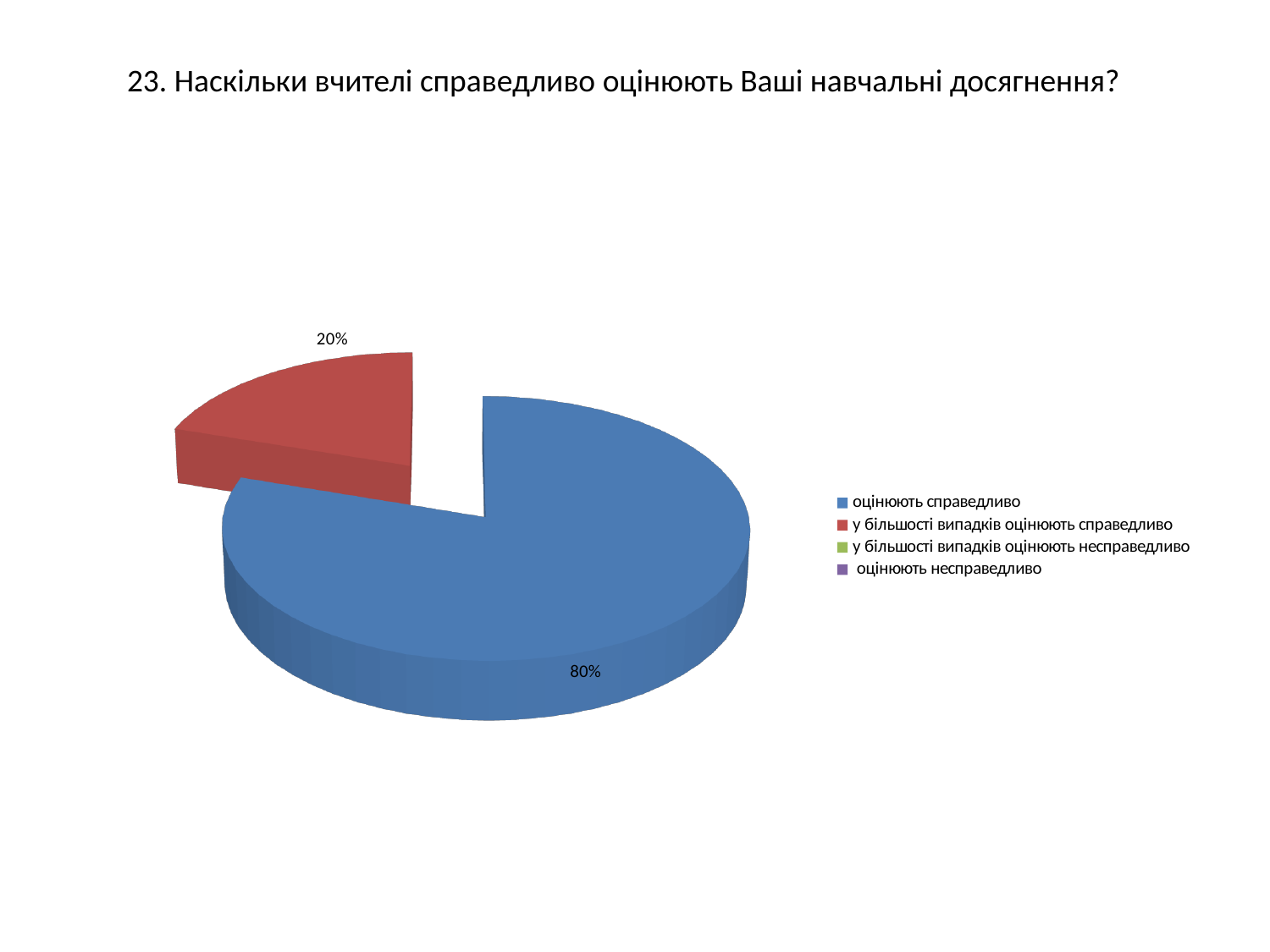
What kind of chart is shown on the slide? pie chart What share of the pie does "у більшості випадків оцінюють справедливо" have? 20% How many slices with data labels are visible in the pie? 2 Which category has the largest slice of the pie? оцінюють справедливо Which of the two visible slices is smaller? у більшості випадків оцінюють справедливо What is the difference in percentage points between the "оцінюють справедливо" slice and the "у більшості випадків оцінюють справедливо" slice? 60 percentage points What share of the pie does "оцінюють справедливо" have? 80% How many entries does the legend list? 4 Which is larger: the share for "оцінюють справедливо" or for "у більшості випадків оцінюють справедливо"? оцінюють справедливо What colour is the slice for "оцінюють справедливо"? blue What is the title of the slide above the chart? 23. Наскільки вчителі справедливо оцінюють Ваші навчальні досягнення?